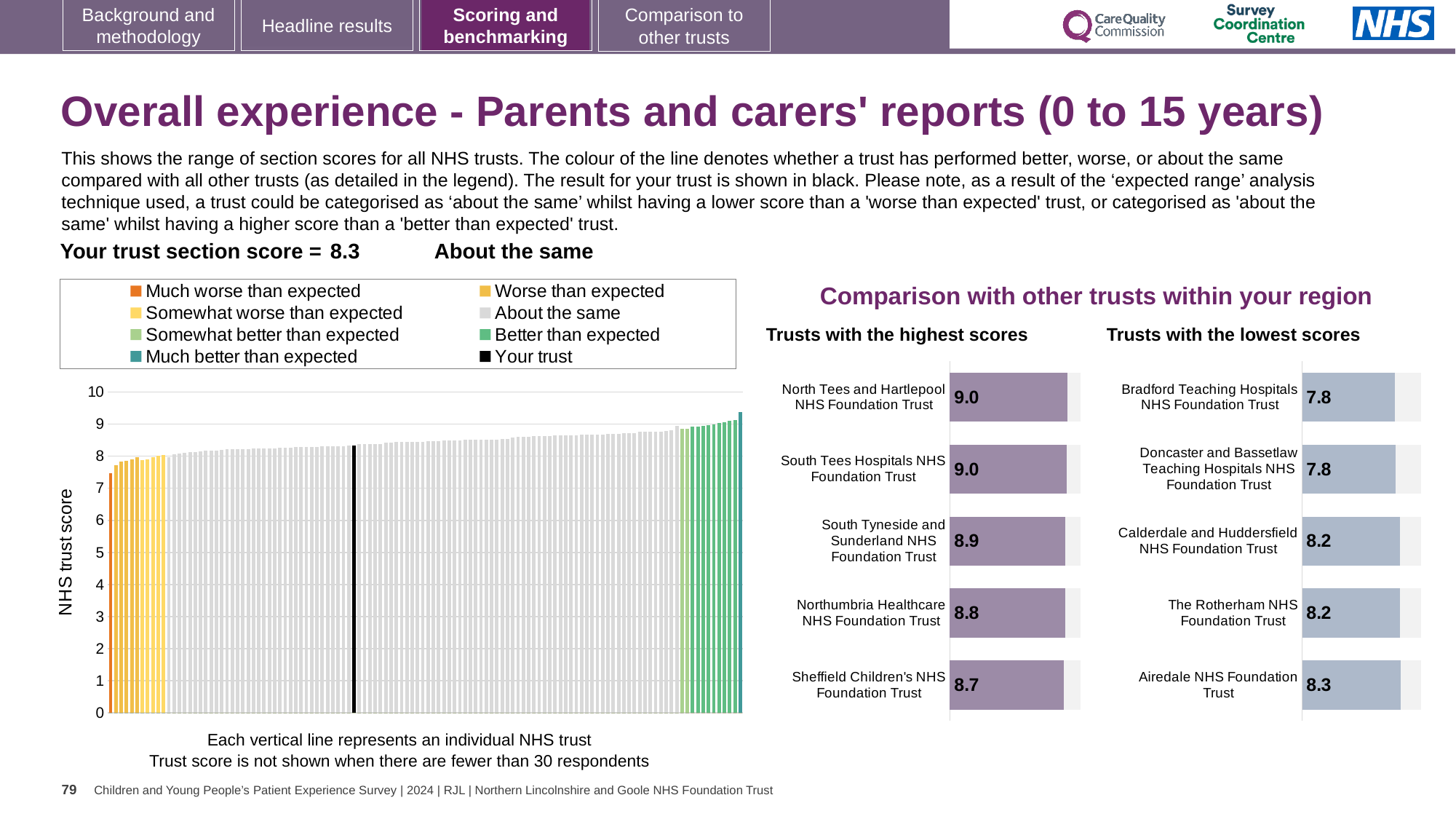
In the 'Trusts with the lowest scores' chart, which trust has the highest score? Airedale NHS Foundation Trust In the 'Trusts with the highest scores' chart, which has the larger score: Northumbria Healthcare NHS Foundation Trust or Sheffield Children's NHS Foundation Trust? Northumbria Healthcare NHS Foundation Trust In the 'Trusts with the lowest scores' chart, what is the difference between the scores of Airedale NHS Foundation Trust and Bradford Teaching Hospitals NHS Foundation Trust? 0.5 What kind of chart is the large chart on the left showing NHS trust scores? Bar chart In the 'Trusts with the highest scores' chart, what is the score for North Tees and Hartlepool NHS Foundation Trust? 9.0 How many entries does the legend of the large chart on the left list? 8 In the 'Trusts with the highest scores' chart, what is the score for Sheffield Children's NHS Foundation Trust? 8.7 In the large chart on the left, do the trust scores rise or fall from left to right? Rise In the 'Trusts with the lowest scores' chart, what is the score for Calderdale and Huddersfield NHS Foundation Trust? 8.2 In the large chart on the left, is the value for the black 'Your trust' bar greater or less than 8? greater In the 'Trusts with the highest scores' chart, which trust has the lowest score? Sheffield Children's NHS Foundation Trust How many trusts are shown in the 'Trusts with the lowest scores' chart? 5